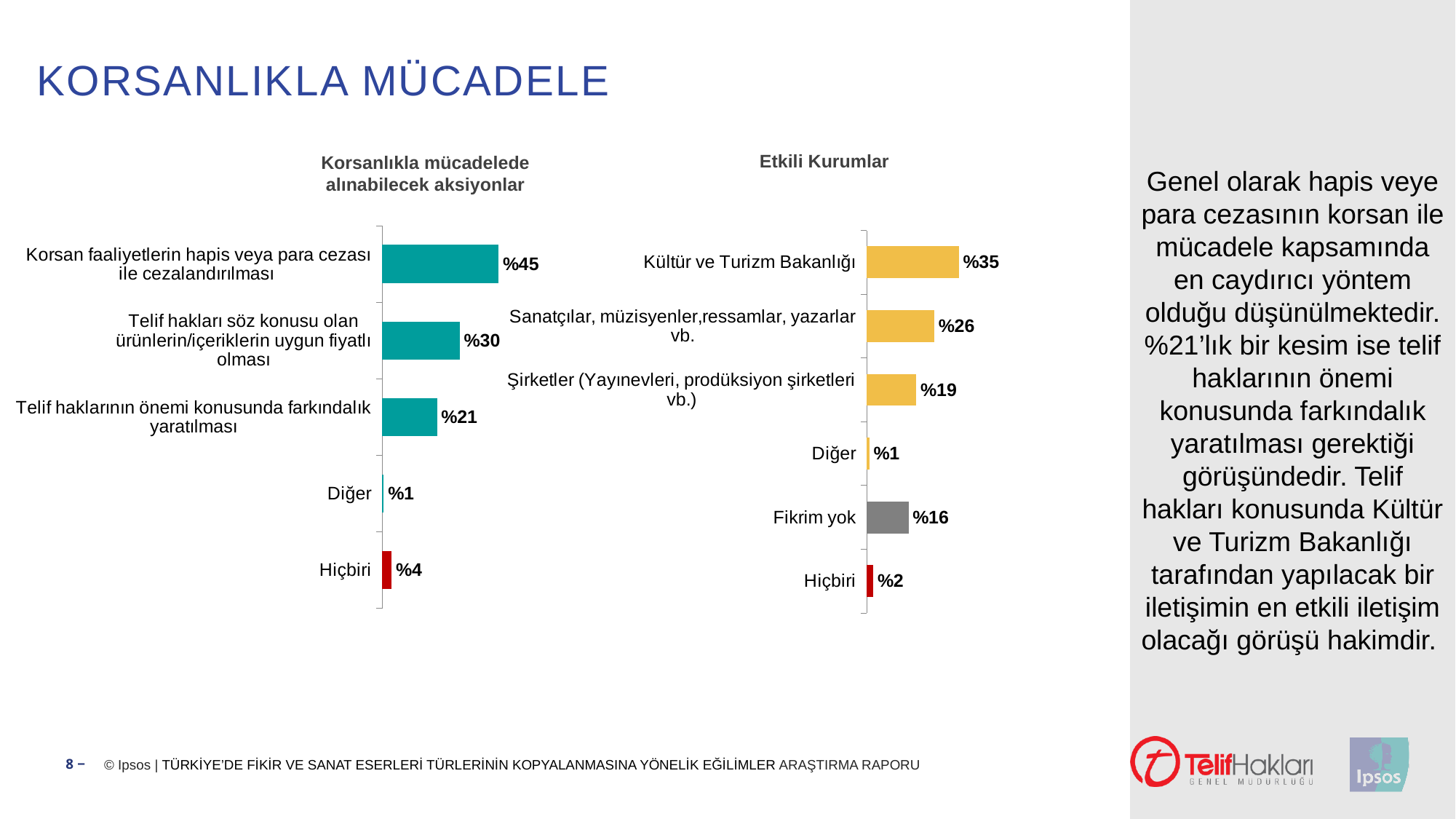
In the 'Etkili Kurumlar' chart, what is the value for 'Fikrim yok'? %16 What type of chart is the 'Etkili Kurumlar' chart? Bar chart In the 'Etkili Kurumlar' chart, which category has the highest value? Kültür ve Turizm Bakanlığı In the 'Korsanlıkla mücadelede alınabilecek aksiyonlar' chart, what is the value for 'Korsan faaliyetlerin hapis veya para cezası ile cezalandırılması'? %45 In the 'Korsanlıkla mücadelede alınabilecek aksiyonlar' chart, how many categories are shown? 5 In the 'Etkili Kurumlar' chart, which is larger: 'Sanatçılar, müzisyenler,ressamlar, yazarlar vb.' or 'Şirketler (Yayınevleri, prodüksiyon şirketleri vb.)'? Sanatçılar, müzisyenler,ressamlar, yazarlar vb. In the 'Korsanlıkla mücadelede alınabilecek aksiyonlar' chart, what is the difference between the values for 'Korsan faaliyetlerin hapis veya para cezası ile cezalandırılması' and 'Telif hakları söz konusu olan ürünlerin/içeriklerin uygun fiyatlı olması'? %15 In the 'Korsanlıkla mücadelede alınabilecek aksiyonlar' chart, which category has the lowest value? Diğer In the 'Etkili Kurumlar' chart, what is the difference between the values for 'Kültür ve Turizm Bakanlığı' and 'Şirketler (Yayınevleri, prodüksiyon şirketleri vb.)'? %16 In the 'Korsanlıkla mücadelede alınabilecek aksiyonlar' chart, what is the value for 'Telif haklarının önemi konusunda farkındalık yaratılması'? %21 In the 'Etkili Kurumlar' chart, how many categories are shown? 6 In the 'Etkili Kurumlar' chart, what is the value for 'Kültür ve Turizm Bakanlığı'? %35